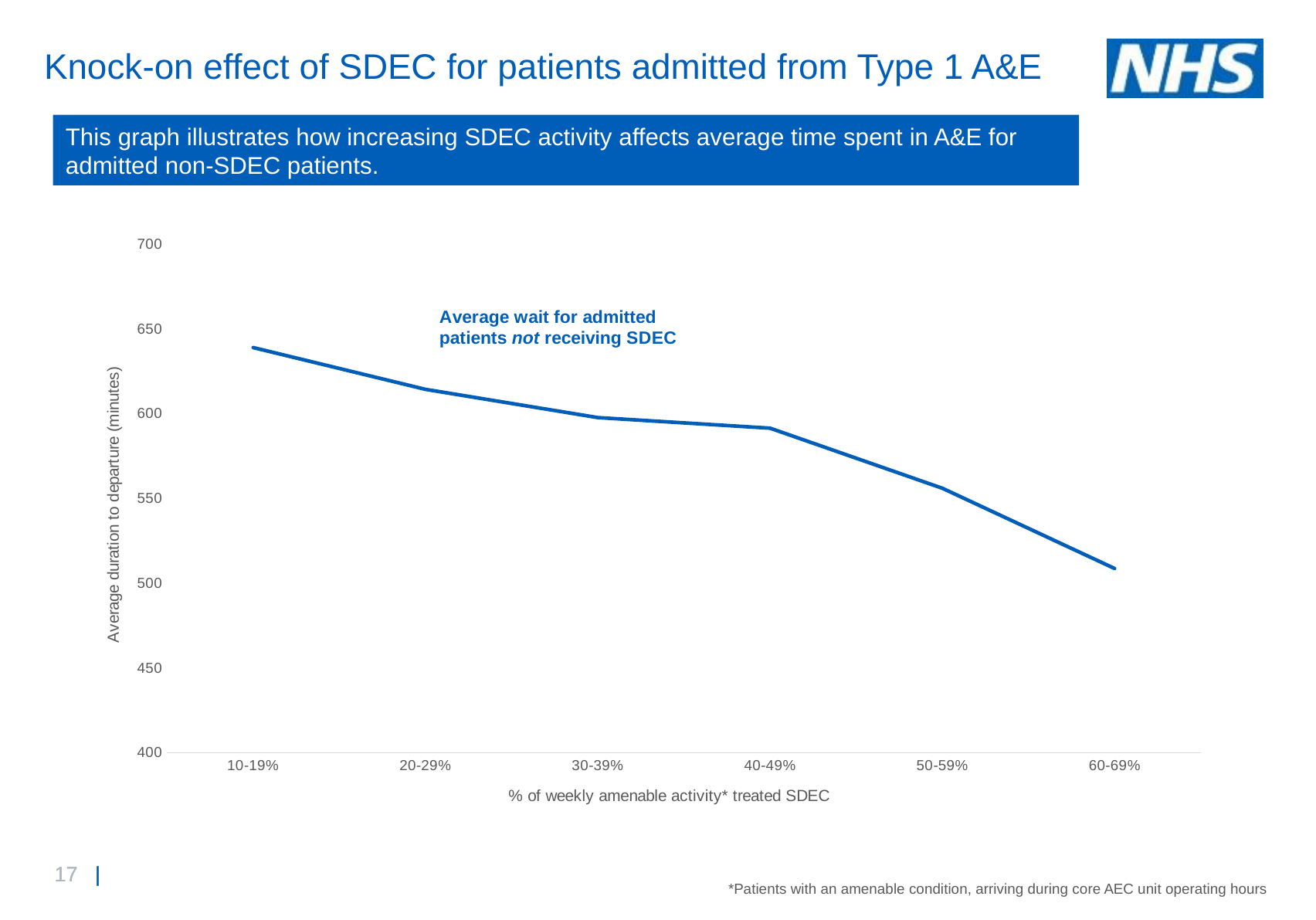
Which category has the highest average duration to departure? 10-19% Which category has the lowest average duration to departure? 60-69% Which is larger, the value for 20-29% or the value for 50-59%? 20-29% Do the values rise or fall as the % of weekly amenable activity treated SDEC increases? fall What is the label on the x axis? % of weekly amenable activity* treated SDEC Is the value for 40-49% greater or less than 550? greater Is the value for 60-69% greater or less than 550? less What is the label on the y axis? Average duration to departure (minutes) Is the value for 50-59% greater or less than 600? less How many categories are shown on the x axis? 6 What kind of chart is shown on the slide? line chart